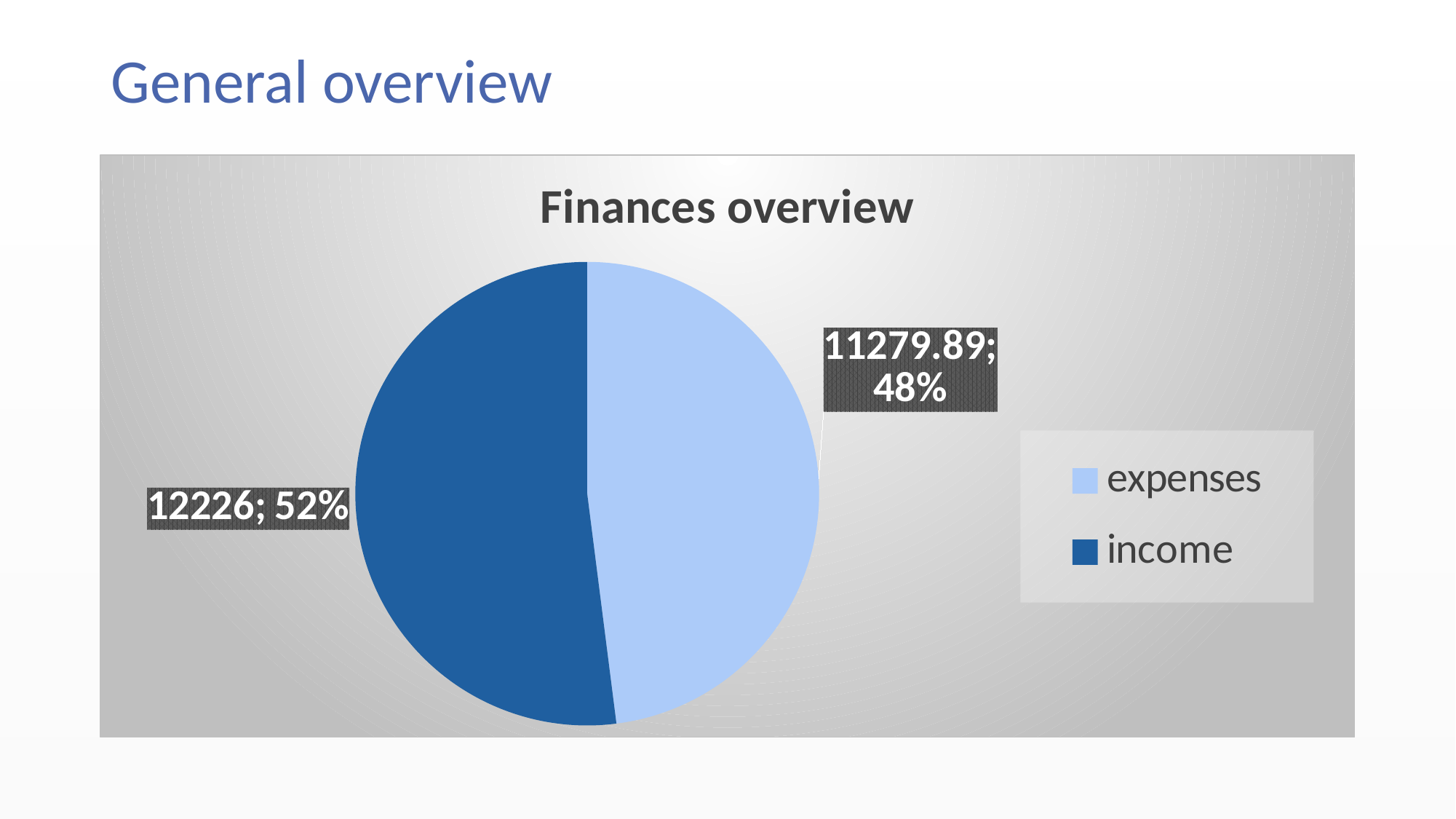
How many slices does the pie chart have? 2 What is the difference between income and expenses? 946.11 Which category has the smallest slice? expenses What kind of chart is shown? pie chart Which category has the largest slice? income What is the title of the chart? Finances overview Which colour represents income in the legend? dark blue What is the value for expenses? 11279.89 Which is larger, income or expenses? income What share of the pie does expenses represent? 48% What share of the pie does income represent? 52% What is the value for income? 12226